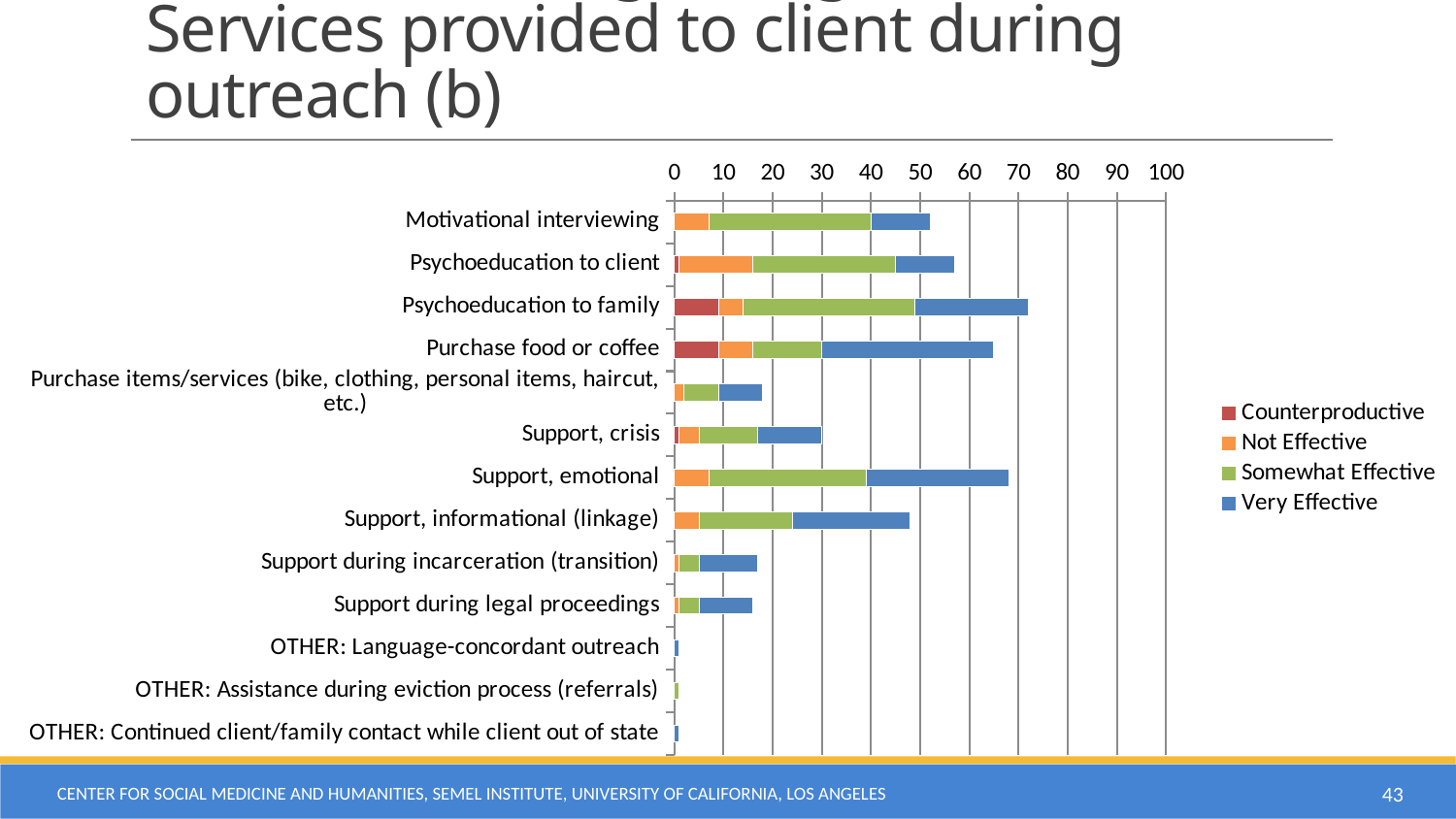
Is the total bar length for Support during legal proceedings greater or less than 20? less What kind of chart is shown on the slide? Stacked bar chart How many series does the legend list? 4 How many service categories are plotted on the chart? 13 Which has the longer total bar: Purchase food or coffee or Support, informational (linkage)? Purchase food or coffee Is the total bar length for Motivational interviewing greater or less than 40? greater Is the total bar length for Psychoeducation to family greater or less than 60? greater Which has the longer total bar: Support, crisis or Support during legal proceedings? Support, crisis What colour represents the Very Effective series in the legend? Blue Which service category has the longest total bar? Psychoeducation to family